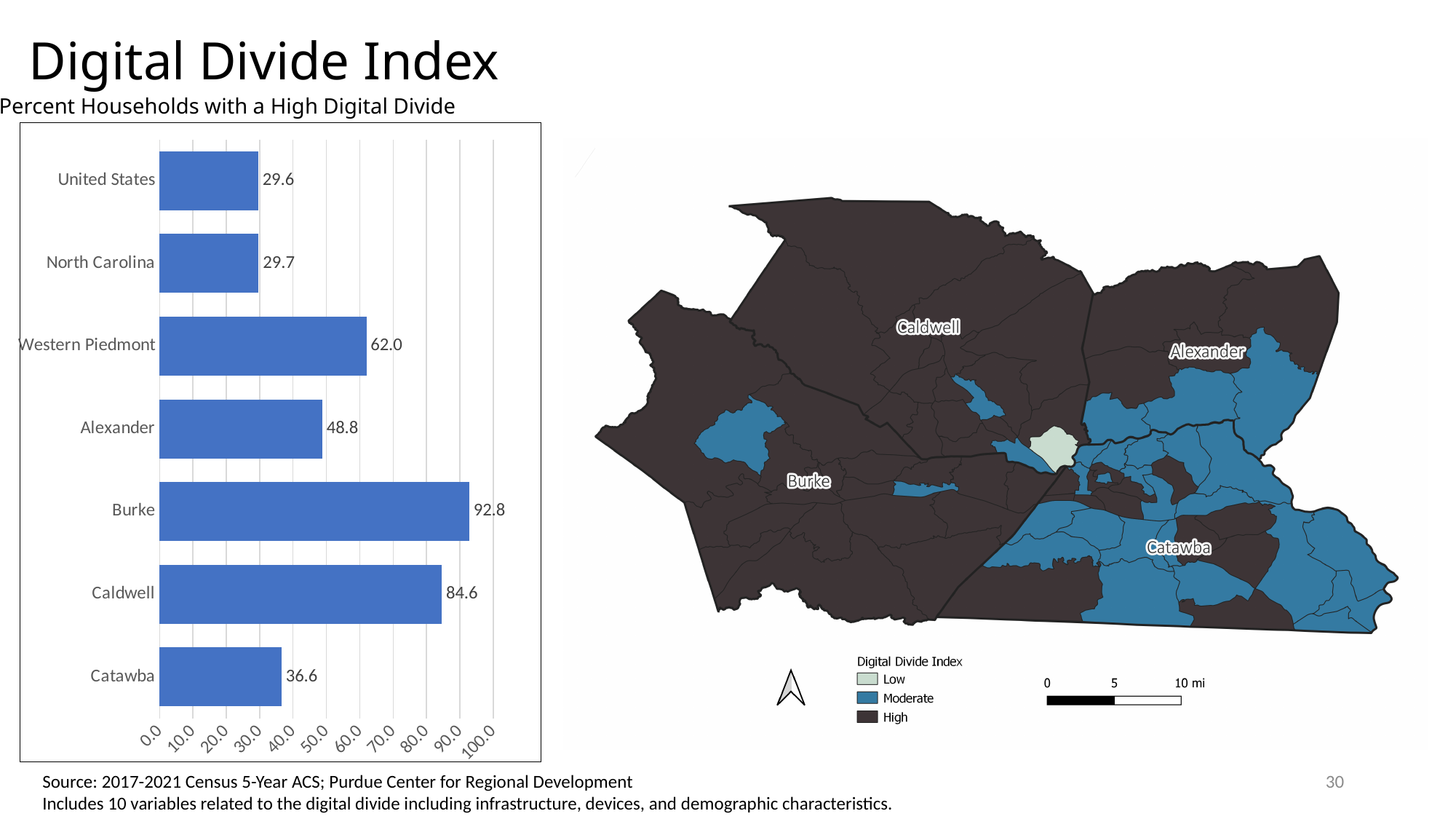
What is the difference between the values for Alexander and Catawba in the bar chart? 12.2 What is the value for Western Piedmont in the bar chart? 62.0 What is the difference between the values for Burke and Caldwell in the bar chart? 8.2 What is the subtitle above the bar chart? Percent Households with a High Digital Divide What kind of chart is shown on the left of the slide? bar chart What is the value for Catawba in the bar chart? 36.6 Is the value for Alexander in the bar chart greater or less than 50.0? less How many categories are shown in the bar chart? 7 What is the value for Burke in the bar chart? 92.8 Which has a larger value in the bar chart, Caldwell or Western Piedmont? Caldwell Which category has the lowest value in the bar chart? United States Which category has the highest value in the bar chart? Burke